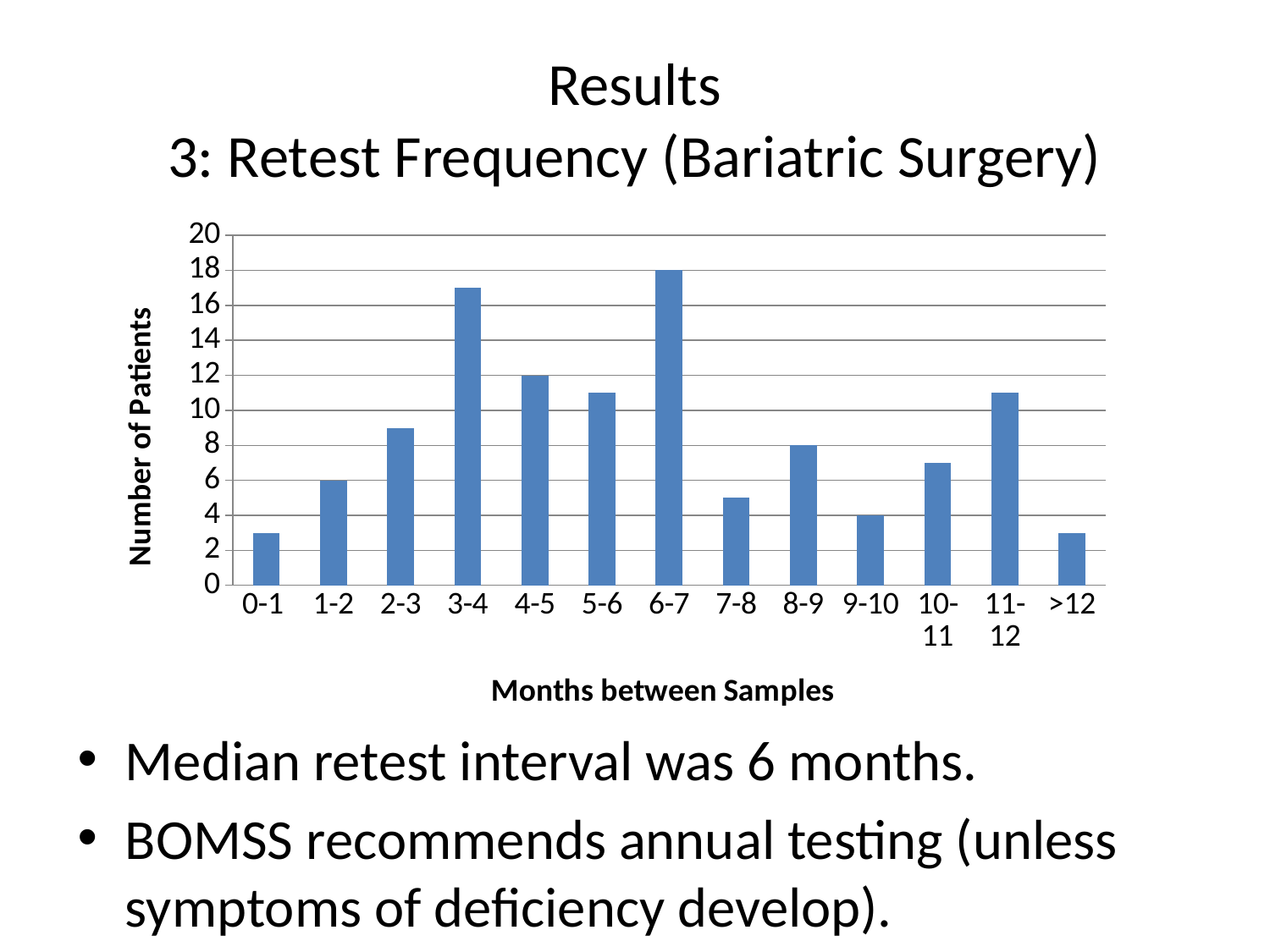
What is the number of patients for the 9-10 months category? 4 How many months-between-samples categories are shown on the x axis? 13 Is the value for the >12 months category greater or less than 4? less What type of chart is shown on the slide? bar chart What is the title of the y axis? Number of Patients Which months-between-samples category has the highest number of patients? 6-7 What is the number of patients for the 4-5 months category? 12 Is the value for the 3-4 months category greater or less than 14? greater Which has more patients, the 8-9 months category or the 1-2 months category? 8-9 What is the difference in number of patients between the 6-7 and 4-5 months categories? 6 What is the number of patients for the 6-7 months category? 18 What is the number of patients for the 1-2 months category? 6